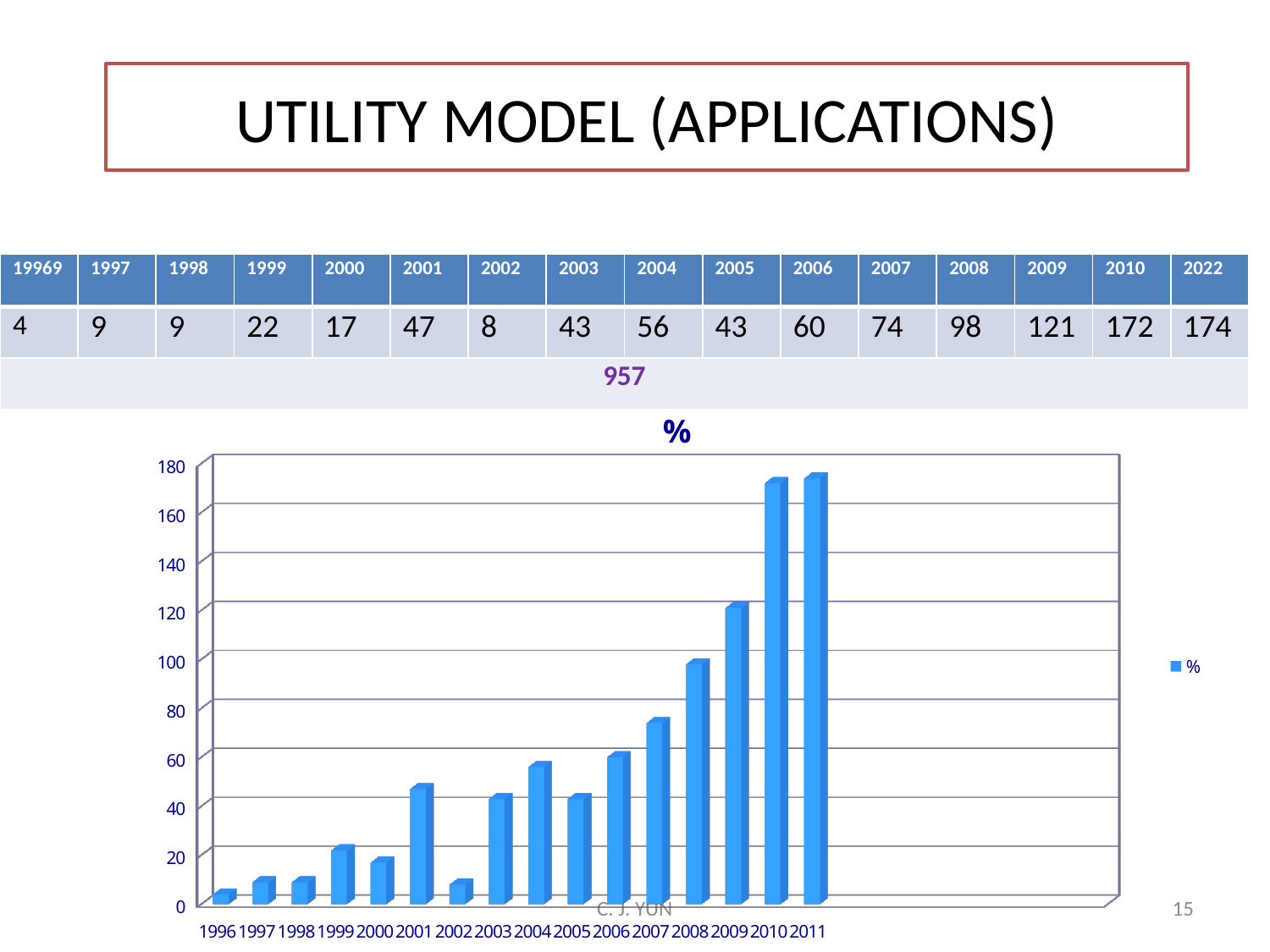
Is the value for 2001 greater or less than 40? greater What is the title of the chart? % Which year has the larger bar, 2008 or 2009? 2009 Is the value for 2009 greater or less than 100? greater How many years are shown along the x axis of the chart? 16 Is the value for 2007 greater or less than 80? less Do the values generally rise or fall from 1996 to 2011? rise Which year has the lowest bar in the chart? 1996 Which year has the larger bar, 2005 or 2006? 2006 What kind of chart is shown on the slide? bar chart How many series does the chart's legend list? 1